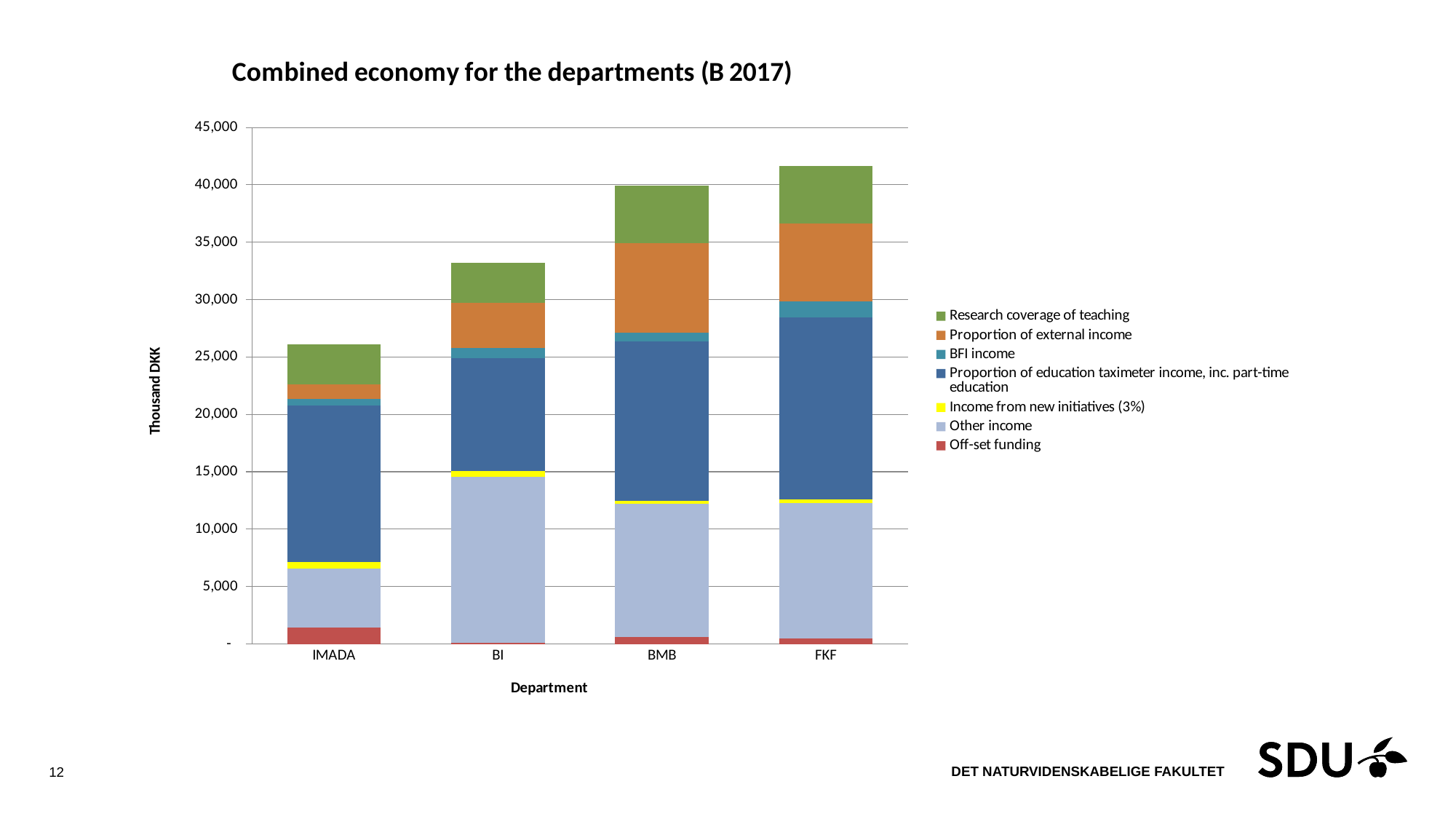
How many series does the chart's legend list? 7 How many departments are shown on the x axis of the chart? 4 What kind of chart is shown on the slide? Stacked bar chart Which department has the largest Off-set funding segment? IMADA Which department has a larger Other income segment, BI or IMADA? BI Is the total for FKF greater or less than 40,000? greater Which department has a larger total, BI or IMADA? BI What is the title of the chart's vertical axis? Thousand DKK Which department has the lowest total stacked bar? IMADA Which department has the highest total stacked bar? FKF Is the total for IMADA greater or less than 30,000? less Is the total for BI greater or less than 30,000? greater